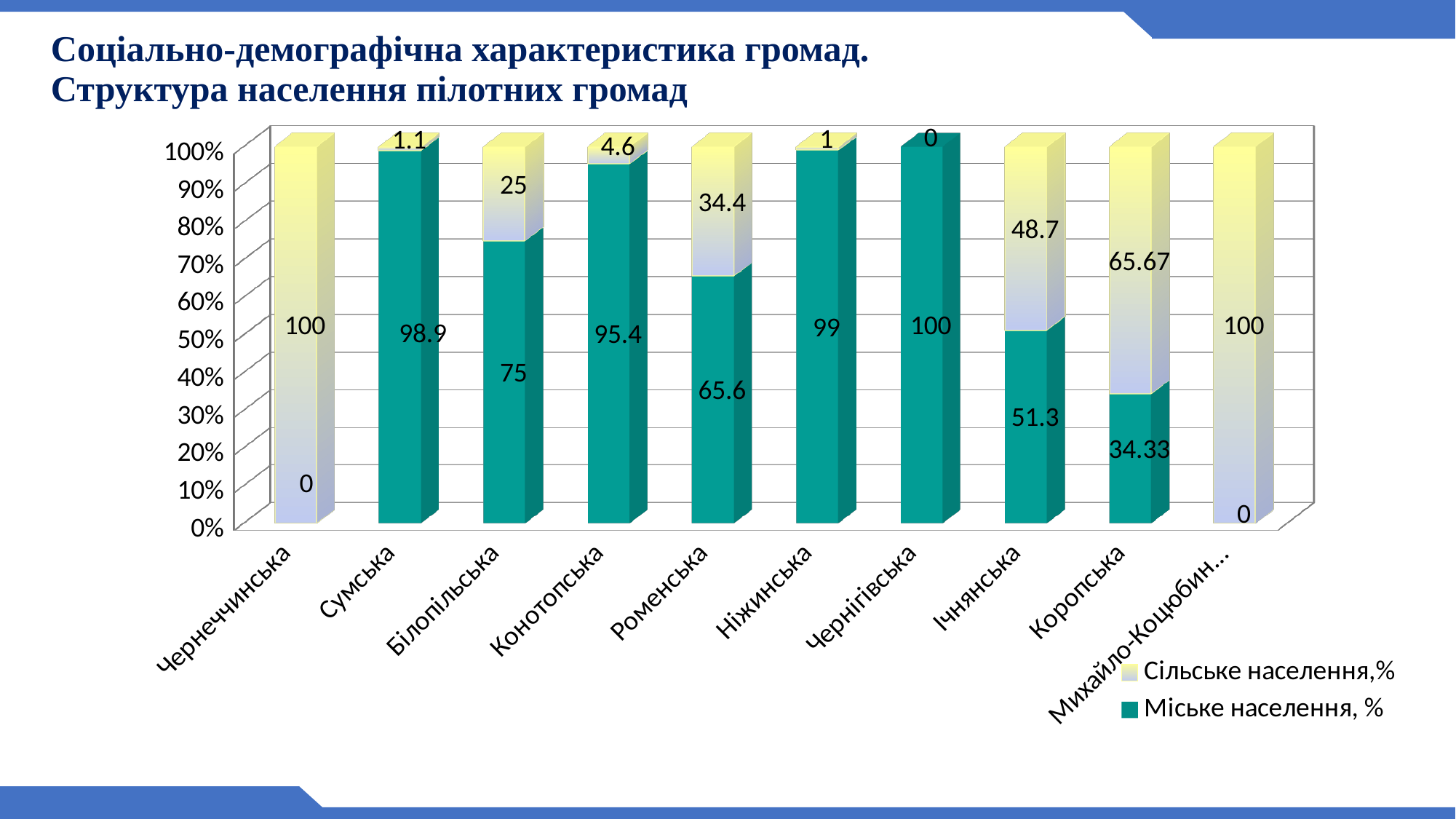
What is the urban population share (Міське населення, %) for Коропська? 34.33 What is the difference between the urban population share of Роменська and that of Ічнянська? 14.3 Which community has the lowest urban population share (Міське населення, %) among Сумська, Конотопська and Ніжинська? Конотопська What is the urban population share (Міське населення, %) for Сумська? 98.9 Which has a larger rural population share (Сільське населення,%): Білопільська or Коропська? Коропська How many communities (categories) are shown on the x axis? 10 What is the rural population share (Сільське населення,%) for Ічнянська? 48.7 Which colour represents Міське населення, % in the legend? Teal (green) What kind of chart is shown on the slide? Stacked bar chart What is the rural population share (Сільське населення,%) for Роменська? 34.4 What is the urban population share (Міське населення, %) for Білопільська? 75 How many series does the legend list? 2